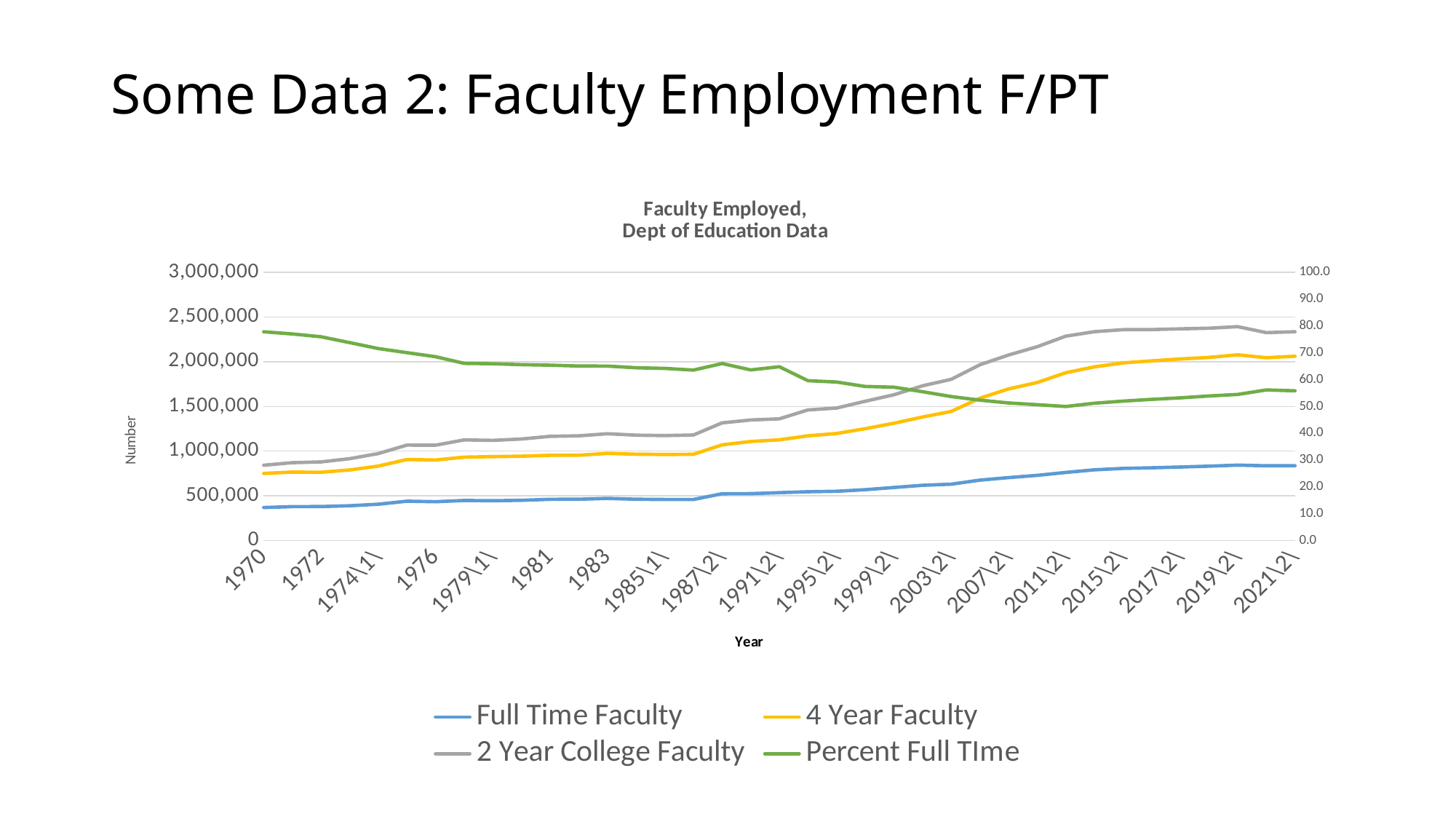
What is the label on the left vertical axis of the chart? Number What kind of chart is shown on the slide? line chart Is the value for Full Time Faculty in 1970 greater or less than 500,000? less Does the Full Time Faculty line rise or fall from 1970 to 2021\2\? rise Does the Percent Full Time line rise or fall overall from 1970 to 2021\2\? fall Is the value for 4 Year Faculty in 1970 greater or less than 1,000,000? less What is the title of the chart? Faculty Employed, Dept of Education Data Is the value for Percent Full Time in 2011\2\ greater or less than 60.0? less How many series does the legend list? 4